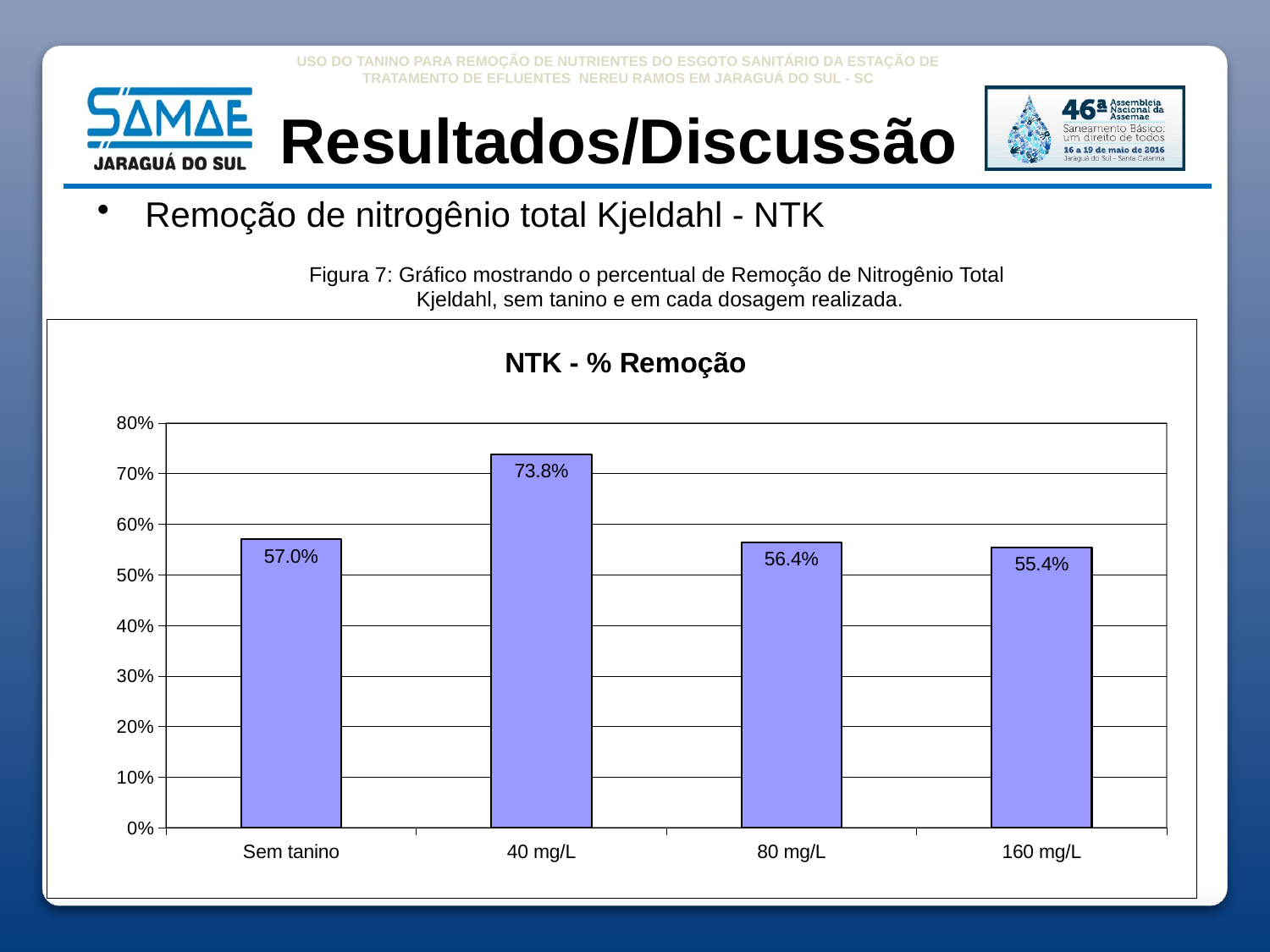
Is the value for 40 mg/L greater or less than 70%? greater How many categories are shown on the x axis of the chart? 4 What is the NTK removal percentage for Sem tanino? 57.0% What is the difference in NTK removal between Sem tanino and 160 mg/L? 1.6% What is the NTK removal percentage for 40 mg/L? 73.8% Which category has the highest NTK removal percentage? 40 mg/L What is the title of the chart? NTK - % Remoção What is the NTK removal percentage for 160 mg/L? 55.4% What is the difference in NTK removal between 40 mg/L and 80 mg/L? 17.4% What kind of chart is shown on the slide? Bar chart Which category has the lowest NTK removal percentage? 160 mg/L Which has a higher NTK removal percentage, Sem tanino or 80 mg/L? Sem tanino